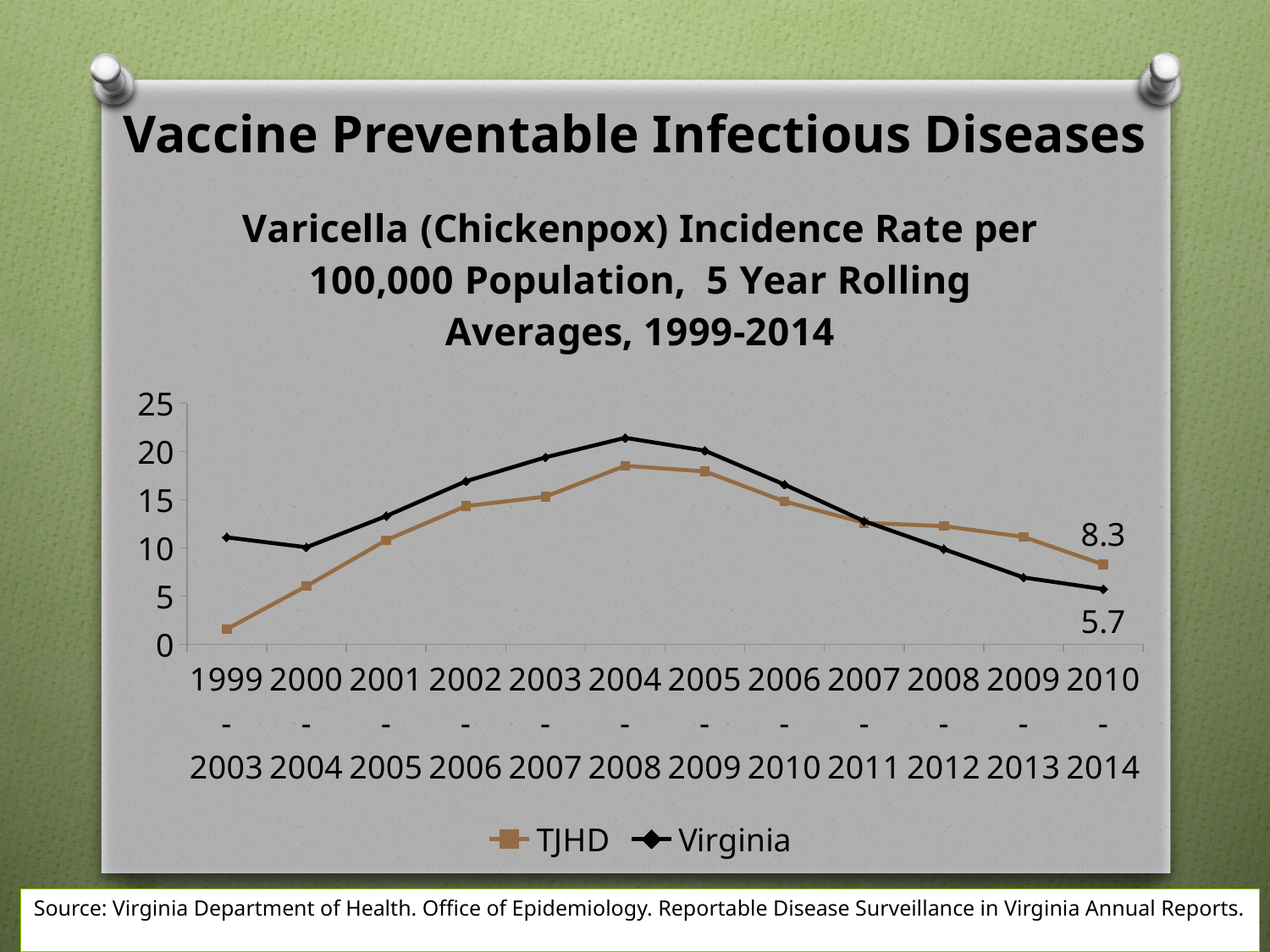
For the 2010-2014 period, which series has the larger value, TJHD or Virginia? TJHD What is the TJHD value for the 2010-2014 period? 8.3 In which period does the TJHD series have its lowest value? 1999-2003 How many periods are shown on the x axis? 12 How many series does the legend list? 2 Is the Virginia value for 2004-2008 greater or less than 20? greater Is the TJHD value for 1999-2003 greater or less than 5? less Is the Virginia value for 2009-2013 greater or less than 10? less What is the difference between the TJHD and Virginia values for 2010-2014? 2.6 In which period does the Virginia series reach its highest value? 2004-2008 What is the Virginia value for the 2010-2014 period? 5.7 What kind of chart is shown on the slide? Line chart